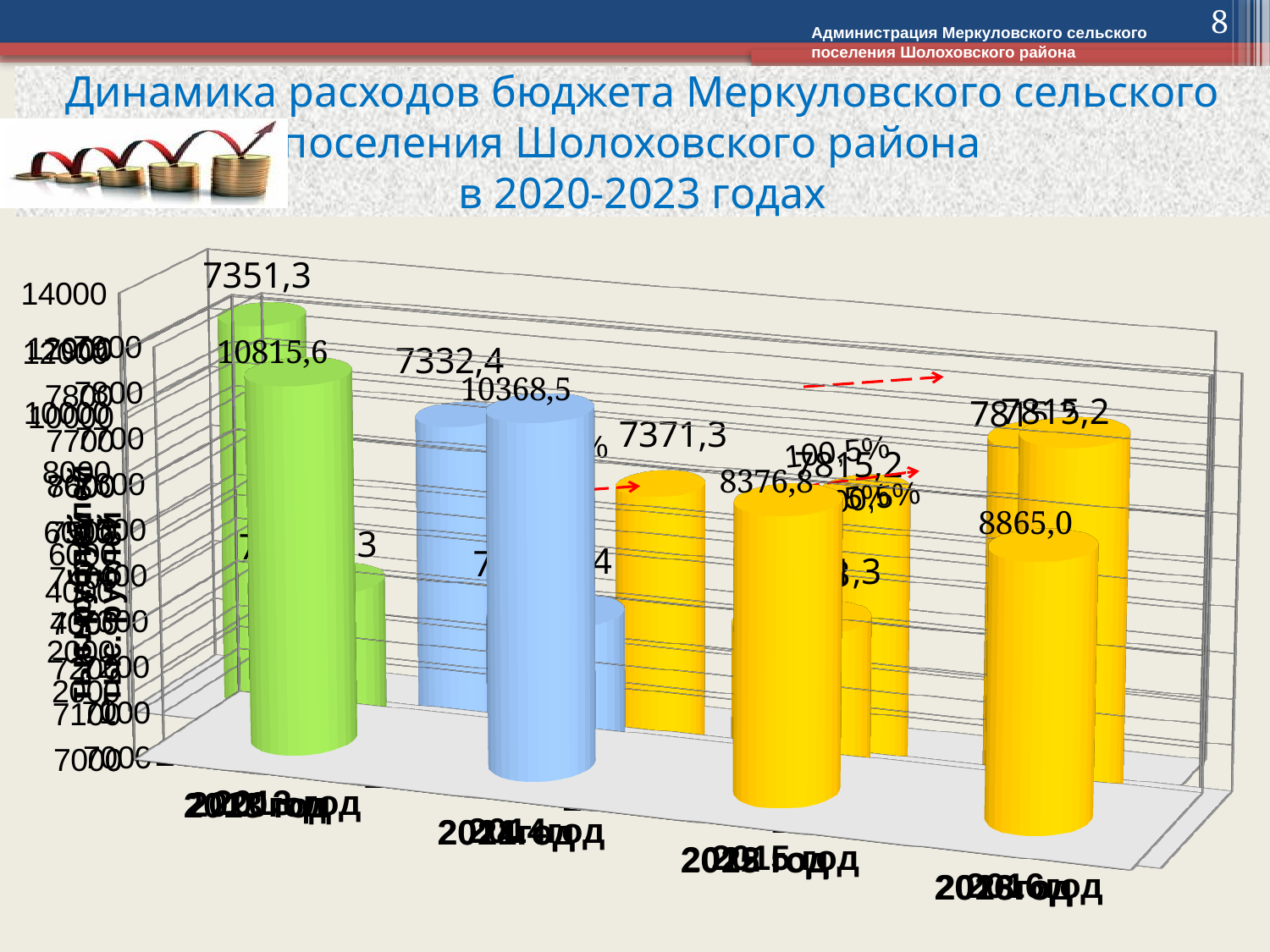
What colour are the bars in the rightmost group of the chart? yellow What is the difference between the bars labelled 8865,0 and 8376,8? 488,2 What is the largest data label printed on the chart? 10815,6 What kind of chart is shown on the slide? bar chart Which is larger, the bar labelled 10815,6 or the bar labelled 10368,5? 10815,6 What is the difference between the bars labelled 10815,6 and 10368,5? 447,1 What is the title of the chart on the slide? Динамика расходов бюджета Меркуловского сельского поселения Шолоховского района в 2020-2023 годах Which is larger, the bar labelled 8865,0 or the bar labelled 8376,8? 8865,0